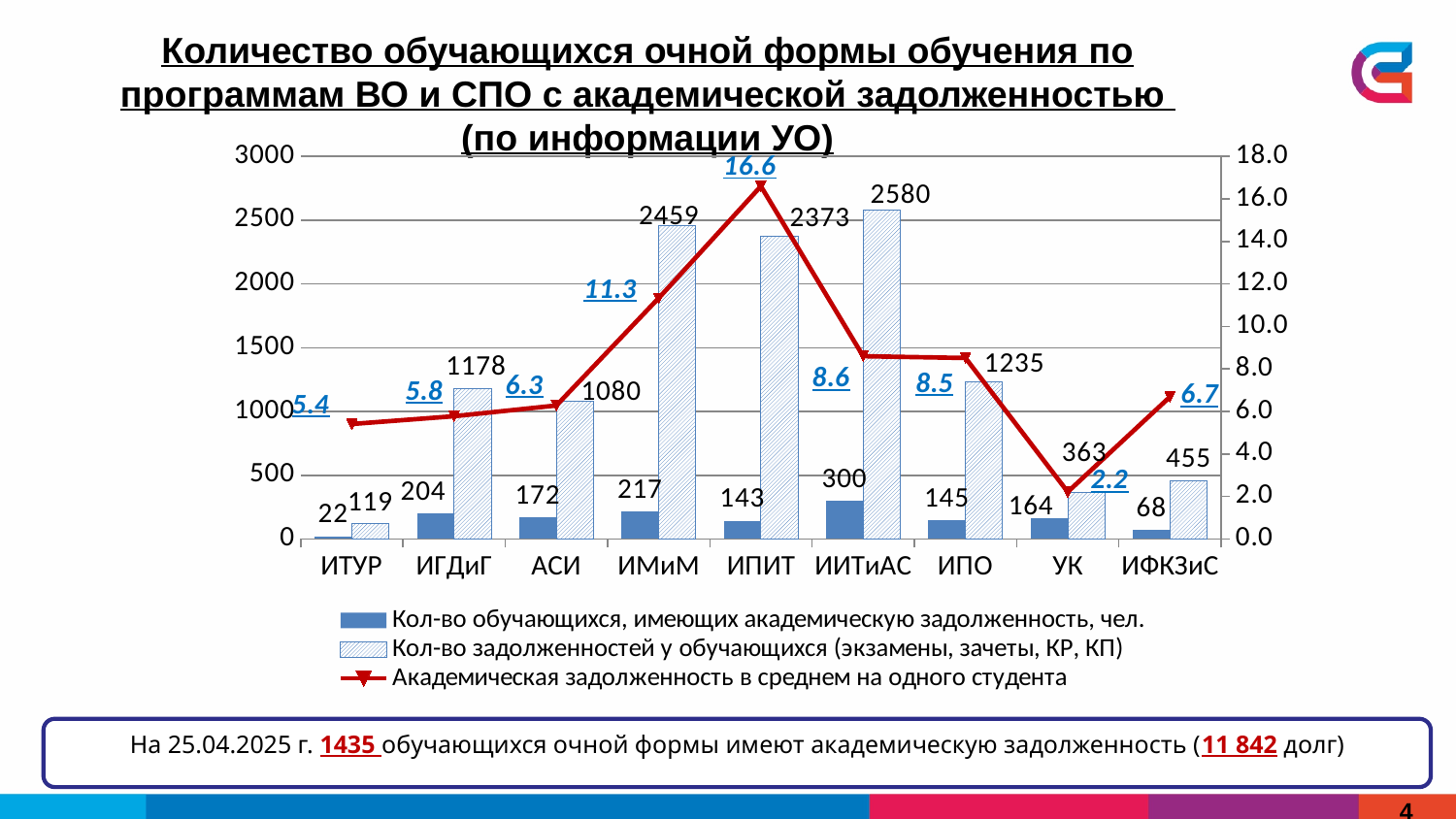
What is the number of debts (Кол-во задолженностей) for ИИТиАС? 2580 What is the maximum value shown on the right-hand y axis? 18.0 What is the difference between the number of debts for ИМиМ and ИПИТ? 86 How many categories are shown on the x axis? 9 Which has more students with academic debt, ИИТиАС or ИМиМ? ИИТиАС How many series does the legend list? 3 Which category has the highest number of debts (Кол-во задолженностей)? ИИТиАС What is the average academic debt per student (Академическая задолженность в среднем на одного студента) for ИПИТ? 16.6 Which category has the lowest average academic debt per student? УК Which category has the lowest number of students with academic debt? ИТУР What kind of chart is this? Combined bar and line chart What is the number of students with academic debt (Кол-во обучающихся, имеющих академическую задолженность) for ИГДиГ? 204